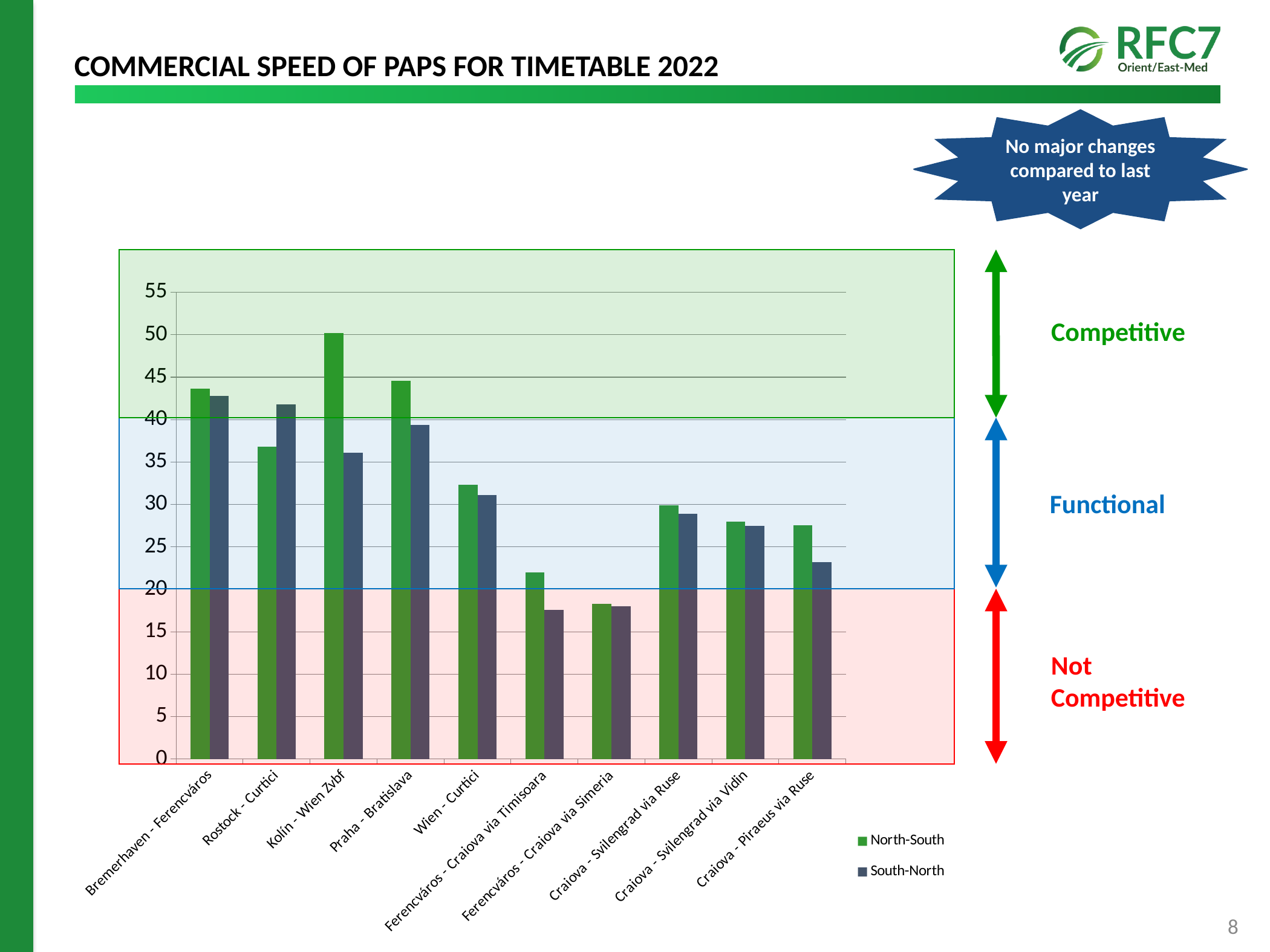
Is the North-South value for Kolín - Wien Zvbf greater or less than 45? greater What kind of chart is shown on the slide? bar chart Is the North-South value for Wien - Curtici greater or less than 30? greater How many series does the chart legend list? 2 Which route has the highest North-South value? Kolín - Wien Zvbf For Craiova - Piraeus via Ruse, which is larger: the North-South or the South-North value? North-South For Rostock - Curtici, which is larger: the North-South or the South-North value? South-North Is the South-North value for Ferencváros - Craiova via Timisoara greater or less than 20? less How many PAP routes (categories) are shown on the x axis? 10 Which route has the lowest North-South value? Ferencváros - Craiova via Simeria What are the two series named in the chart legend? North-South and South-North